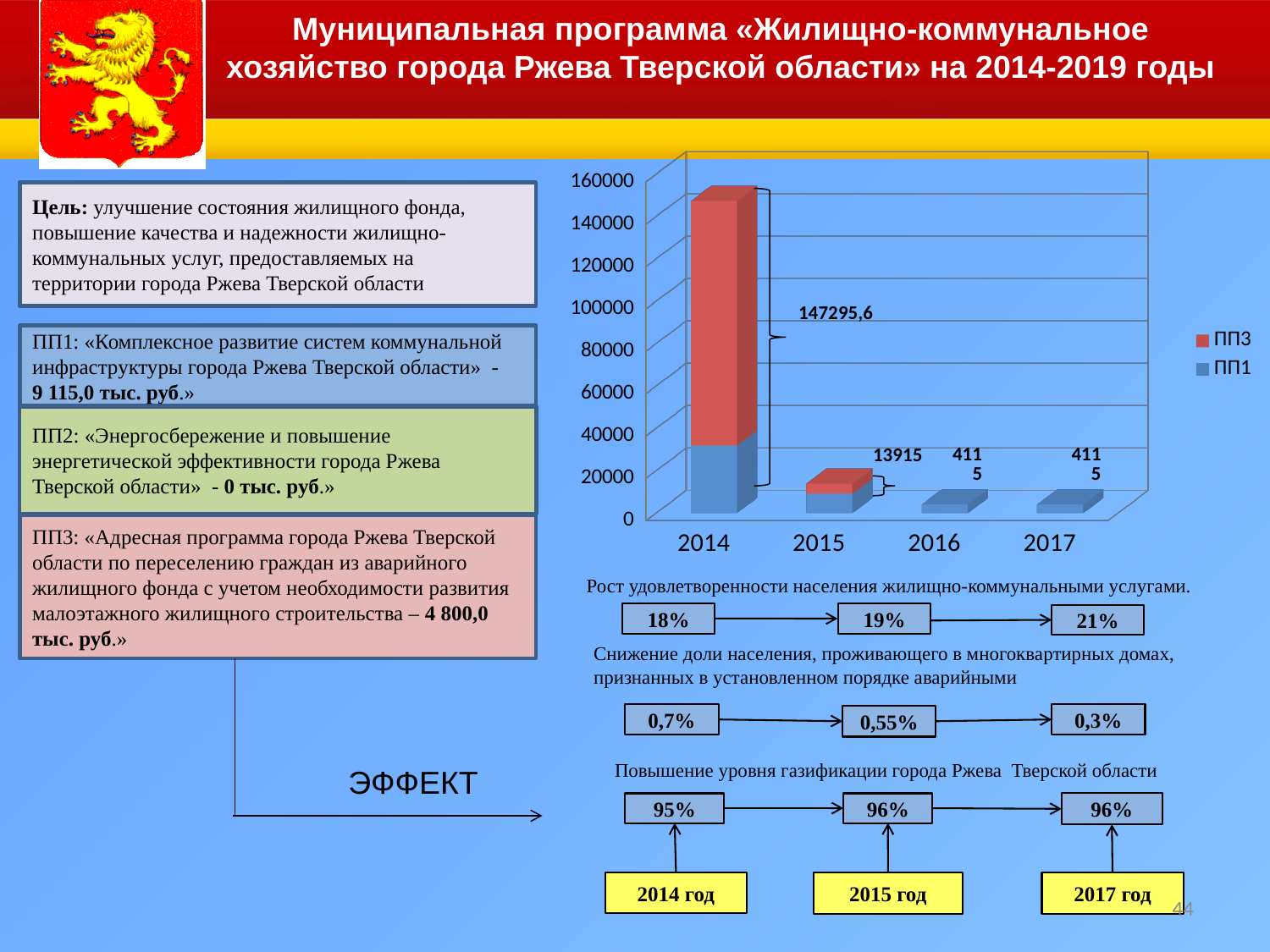
How many years are shown on the x axis of the chart? 4 Is the value for 2014 greater or less than 140000? greater What is the difference between the labelled values for 2014 and 2015? 133380,6 Is the value for 2015 greater or less than 20000? less What value is labelled for the 2015 bar in the chart? 13915 Which year has the highest bar in the chart? 2014 Do the bar values rise or fall from 2014 to 2017? fall What value is labelled for the 2014 bar in the chart? 147295,6 How many series does the chart legend list? 2 What are the two series names listed in the chart legend? ПП3 and ПП1 What kind of chart is shown on the slide? bar chart Which is larger, the bar for 2014 or the bar for 2015? 2014